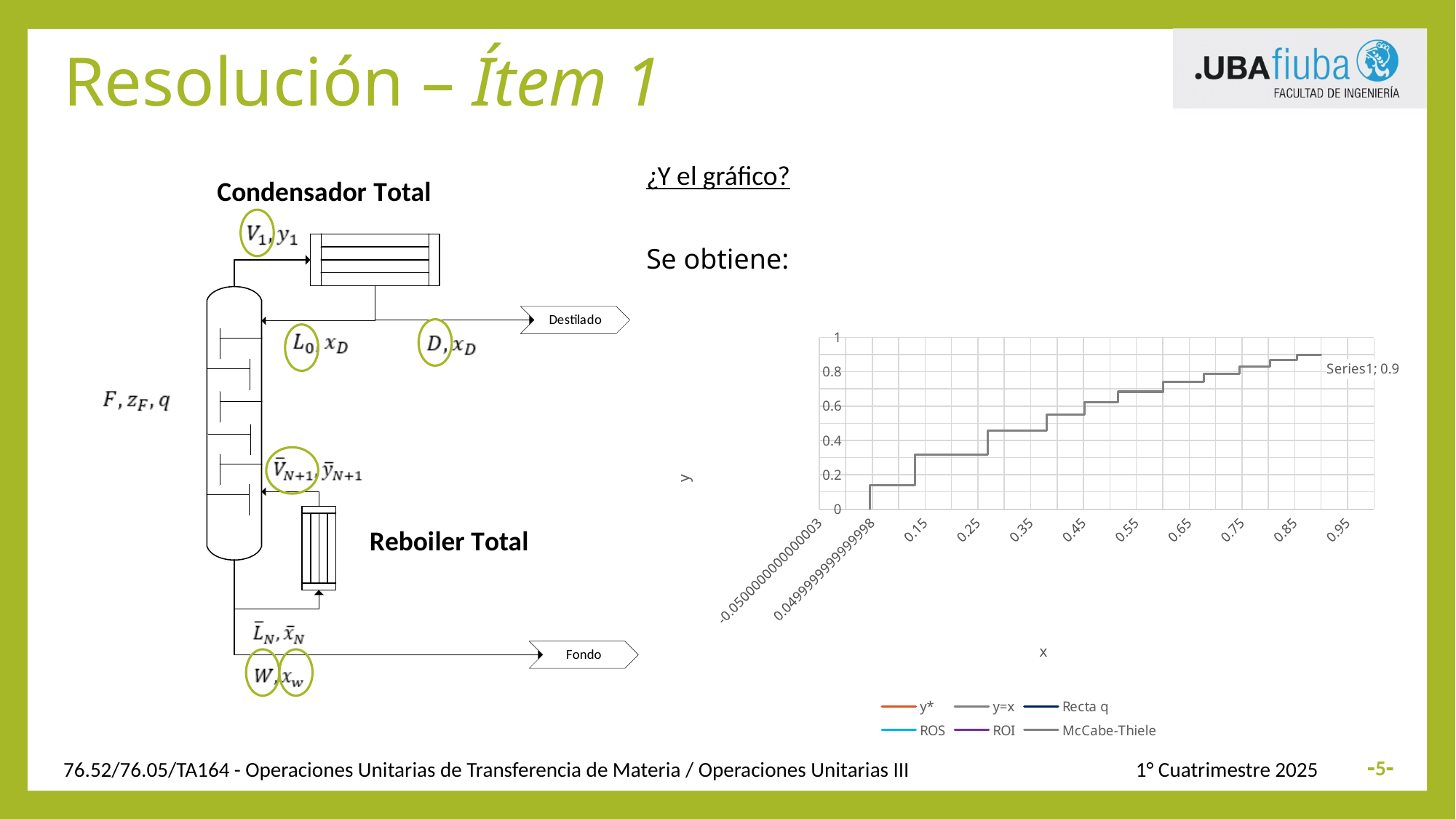
What value is shown by the data label at the end of the plotted staircase line? 0.9 What are the entries listed in the chart's legend? y*, y=x, Recta q, ROS, ROI, McCabe-Thiele What are the titles of the horizontal and vertical axes of the chart? x and y Do the plotted values rise or fall as x increases along the horizontal axis? rise What is the highest plotted y value on the chart, as printed in its data label? 0.9 What is the highest tick value shown on the vertical axis of the chart? 1 Is the plotted y value at x = 0.25 greater or less than 0.2? greater What kind of chart is shown on the right side of the slide? line chart Is the plotted y value at x = 0.65 greater or less than 0.6? greater Which series name appears in the data label at the top right of the plotted line? Series1 How many series does the legend of the chart list? 6 Is the plotted y value at x = 0.45 greater or less than 0.4? greater